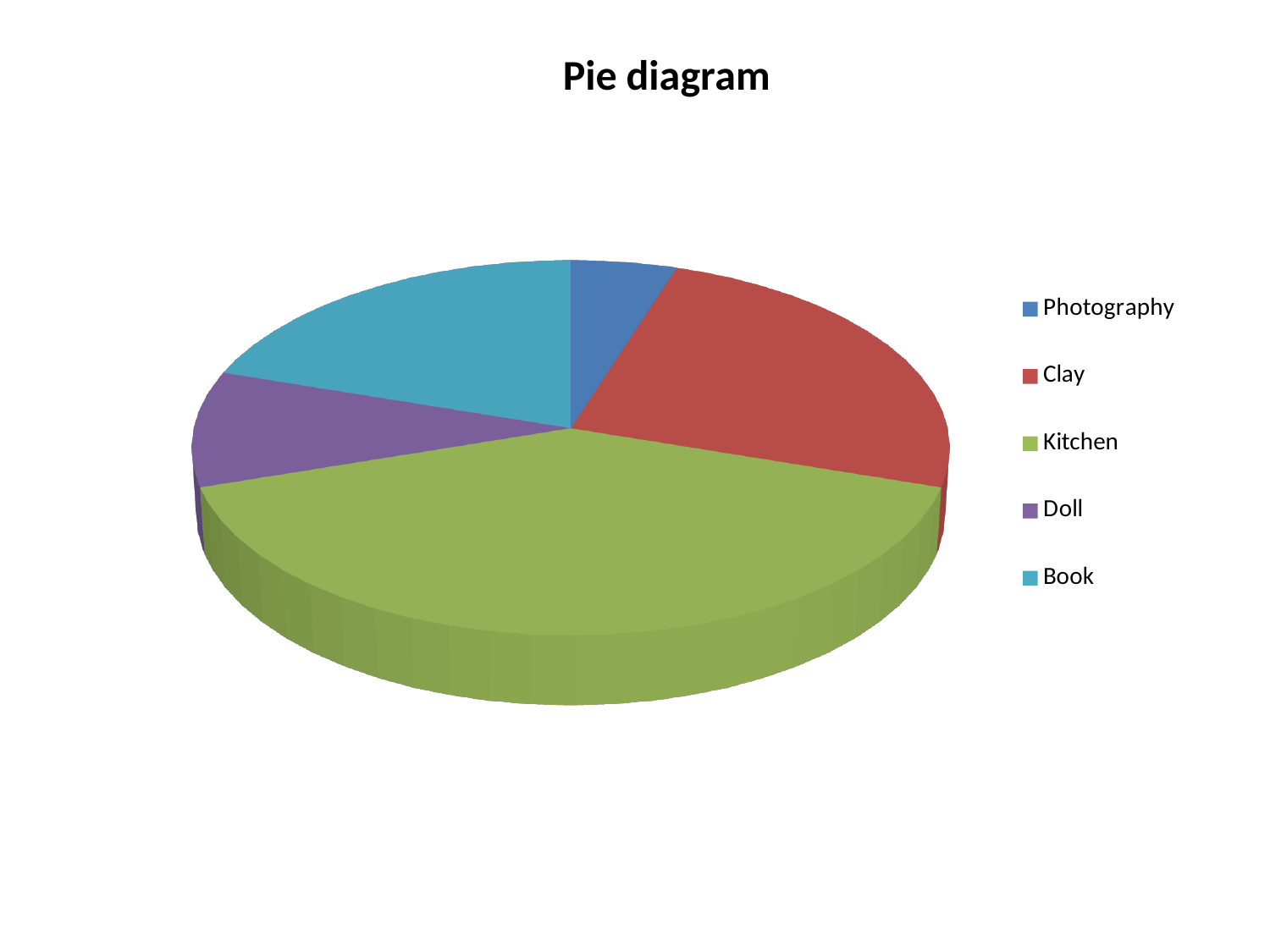
Which slice is larger, Clay or Doll? Clay What kind of chart is shown on the slide? pie chart Which slice is larger, Kitchen or Book? Kitchen Which category has the largest slice of the pie? Kitchen What is the title of the chart? Pie diagram Which slice is larger, Book or Doll? Book Which category has the smallest slice of the pie? Photography How many categories does the pie chart show? 5 Which category is shown in green in the pie chart? Kitchen